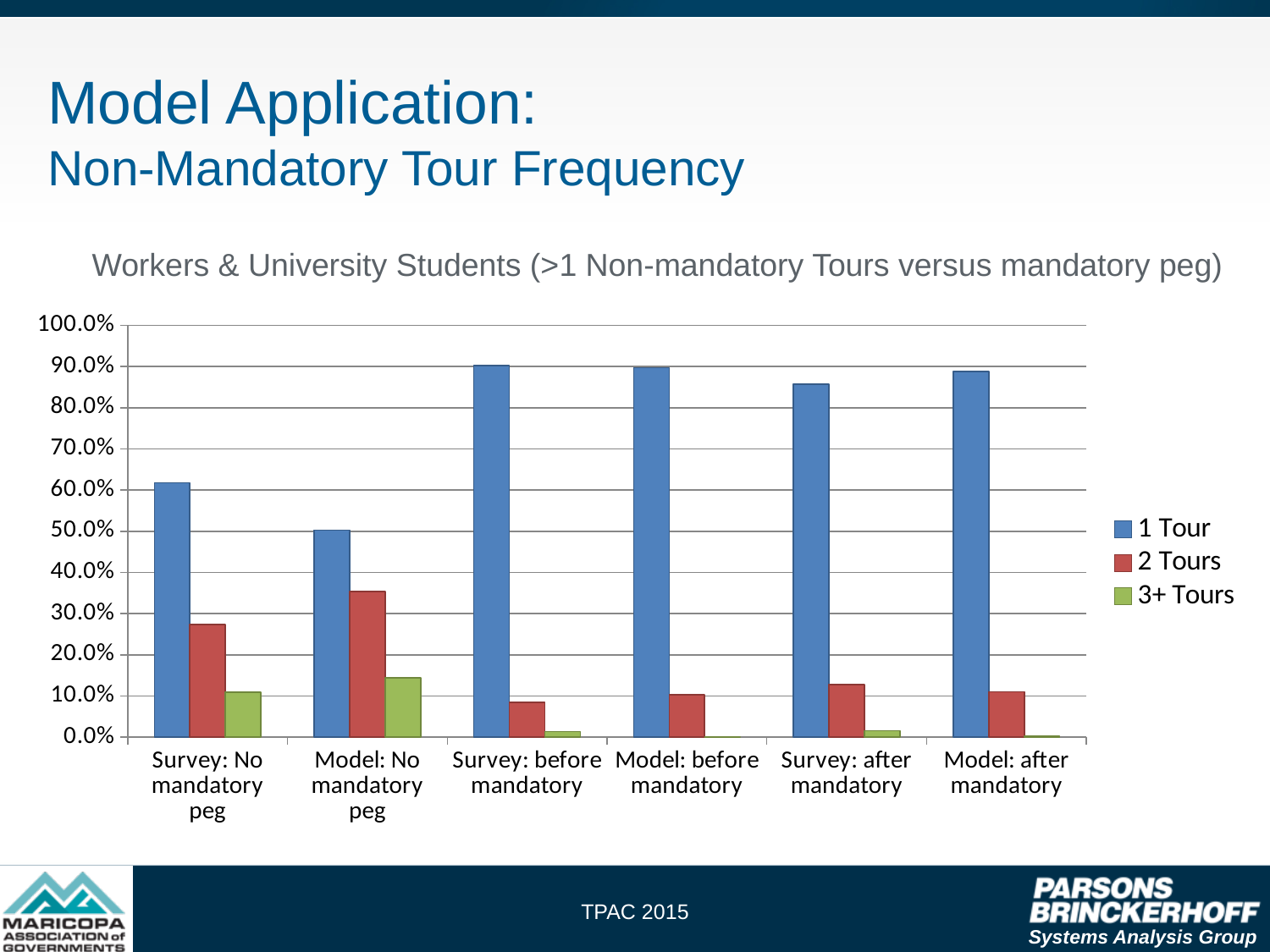
Which is larger for 1 Tour: Survey: No mandatory peg or Model: No mandatory peg? Survey: No mandatory peg Which category has the lowest value for 1 Tour? Model: No mandatory peg What kind of chart is shown on the slide? bar chart Which category has the highest value for 3+ Tours? Model: No mandatory peg Is the 1 Tour value for Survey: after mandatory greater or less than 90.0%? less What is the title of the chart? Workers & University Students (>1 Non-mandatory Tours versus mandatory peg) How many series does the legend list? 3 Is the 2 Tours value for Model: No mandatory peg greater or less than 30.0%? greater Which category has the highest value for 2 Tours? Model: No mandatory peg Is the 2 Tours value for Survey: No mandatory peg greater or less than 30.0%? less How many categories are shown on the x axis? 6